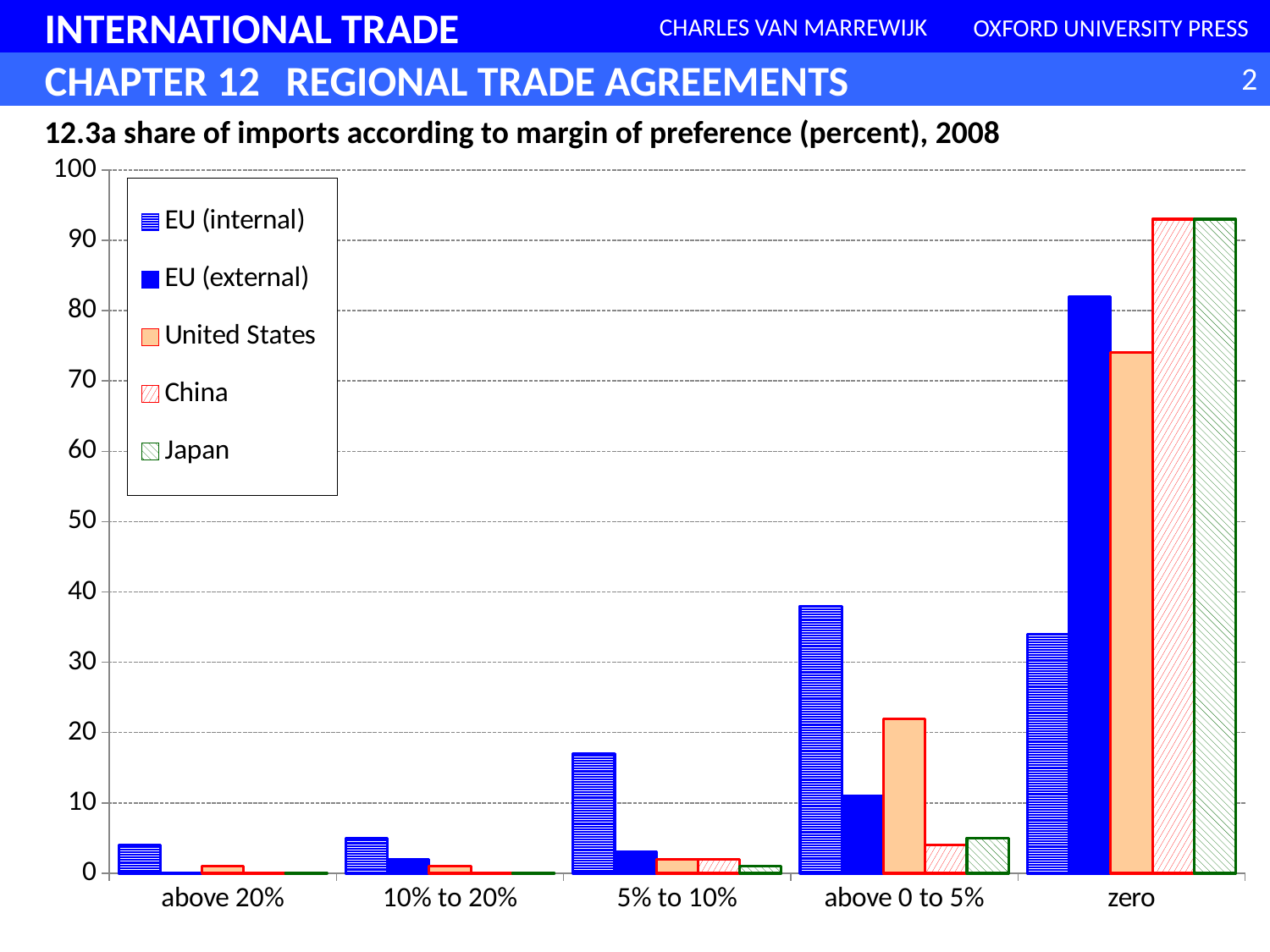
What is the title of the chart? 12.3a share of imports according to margin of preference (percent), 2008 For EU (internal), which category has the highest value? above 0 to 5% How many margin-of-preference categories are shown on the x axis? 5 Is the value for EU (internal) in the '5% to 10%' category greater or less than 20? less How many series does the legend list? 5 What kind of chart is shown on the slide? bar chart Is the value for China in the 'zero' category greater or less than 90? greater In the 'zero' category, which is larger: EU (external) or United States? EU (external) Which series has the highest value in the 'above 0 to 5%' category? EU (internal) Do the values for EU (external) rise or fall moving from 'above 20%' to 'zero' along the x axis? rise Is the value for United States in the 'zero' category greater or less than 70? greater For the United States, which category has the highest value? zero